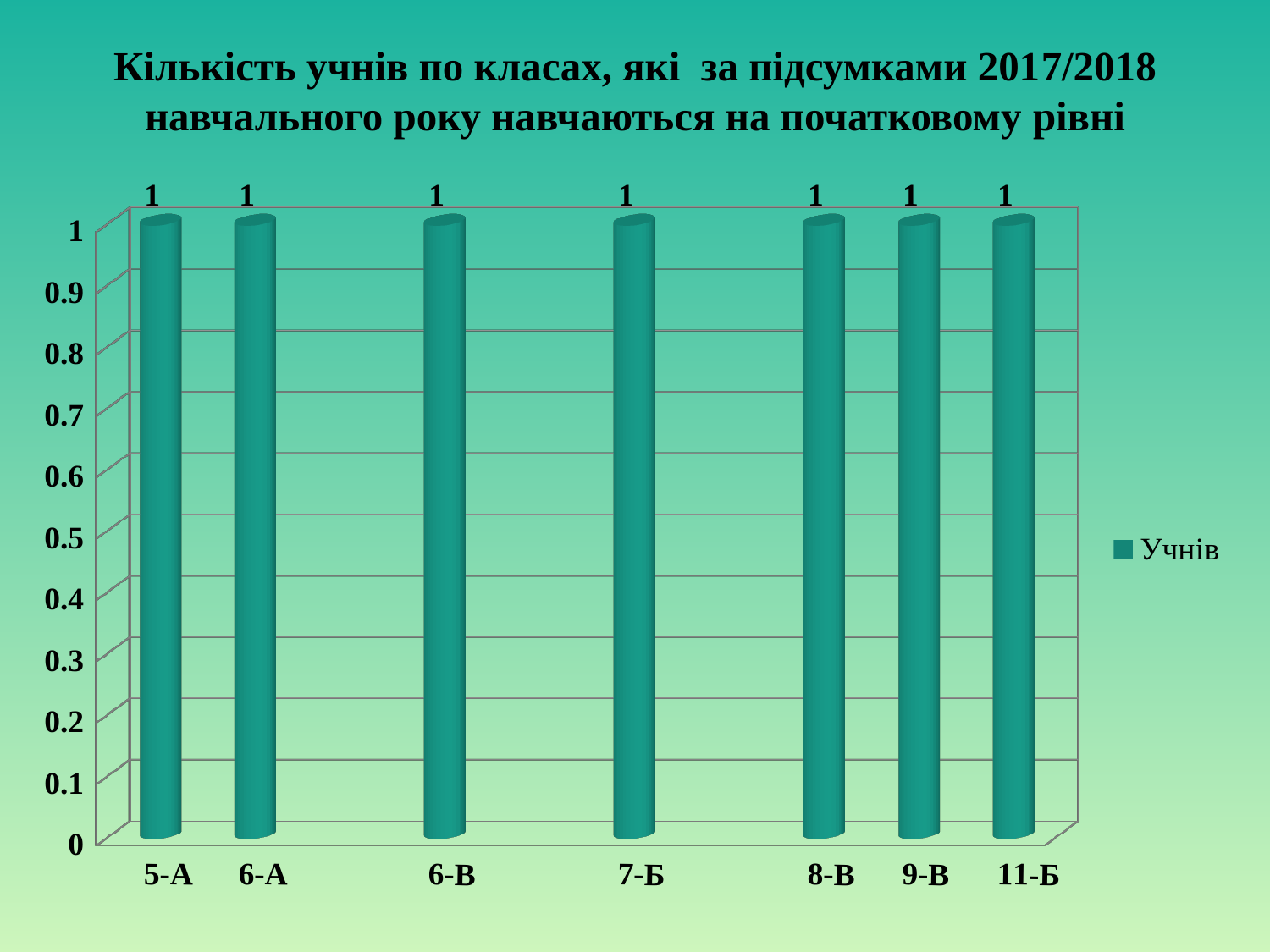
What is the value for class 7-Б? 1 How many classes are shown on the x axis? 7 Is the value for 6-В greater or less than 0.5? greater How many series does the legend list? 1 What is the value for class 9-В? 1 What is the name of the series in the legend? Учнів What kind of chart is shown on the slide? bar chart What is the value for class 11-Б? 1 What is the value for class 5-А? 1 What is the highest value shown on the vertical axis? 1 Do the values rise, fall, or stay the same across the classes from 5-А to 11-Б? stay the same What is the difference between the values for 6-А and 8-В? 0